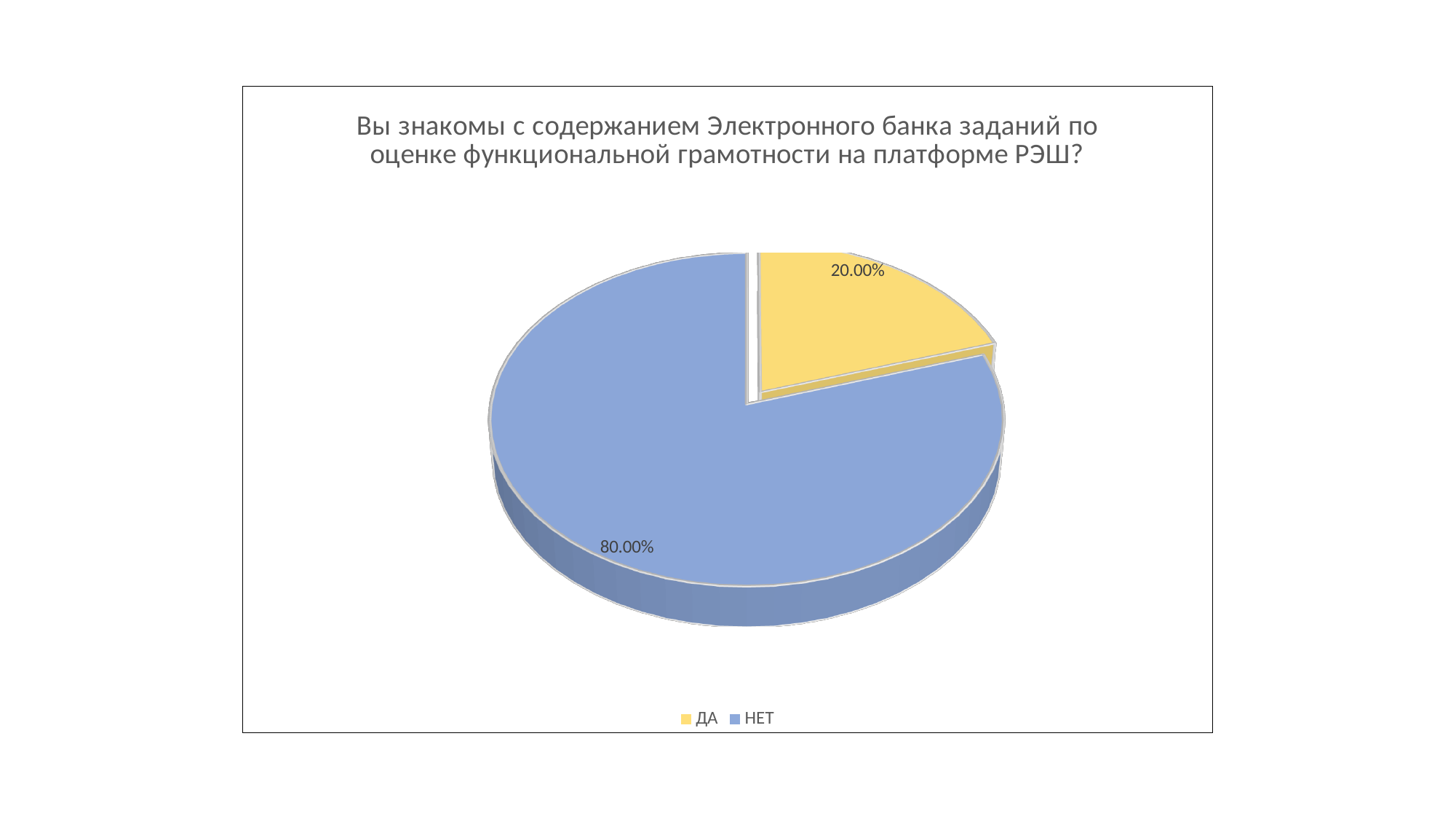
What is the title of the chart? Вы знакомы с содержанием Электронного банка заданий по оценке функциональной грамотности на платформе РЭШ? Which category has the largest slice of the pie? НЕТ What kind of chart is shown on the slide? pie chart How many categories does the pie chart show? 2 What share of the pie does НЕТ represent? 80.00% Which is larger, the ДА slice or the НЕТ slice? НЕТ What colour is the ДА slice? yellow Which category has the smallest slice of the pie? ДА What share of the pie does ДА represent? 20.00% What is the difference in percentage points between the НЕТ and ДА slices? 60.00% How many entries does the legend list? 2